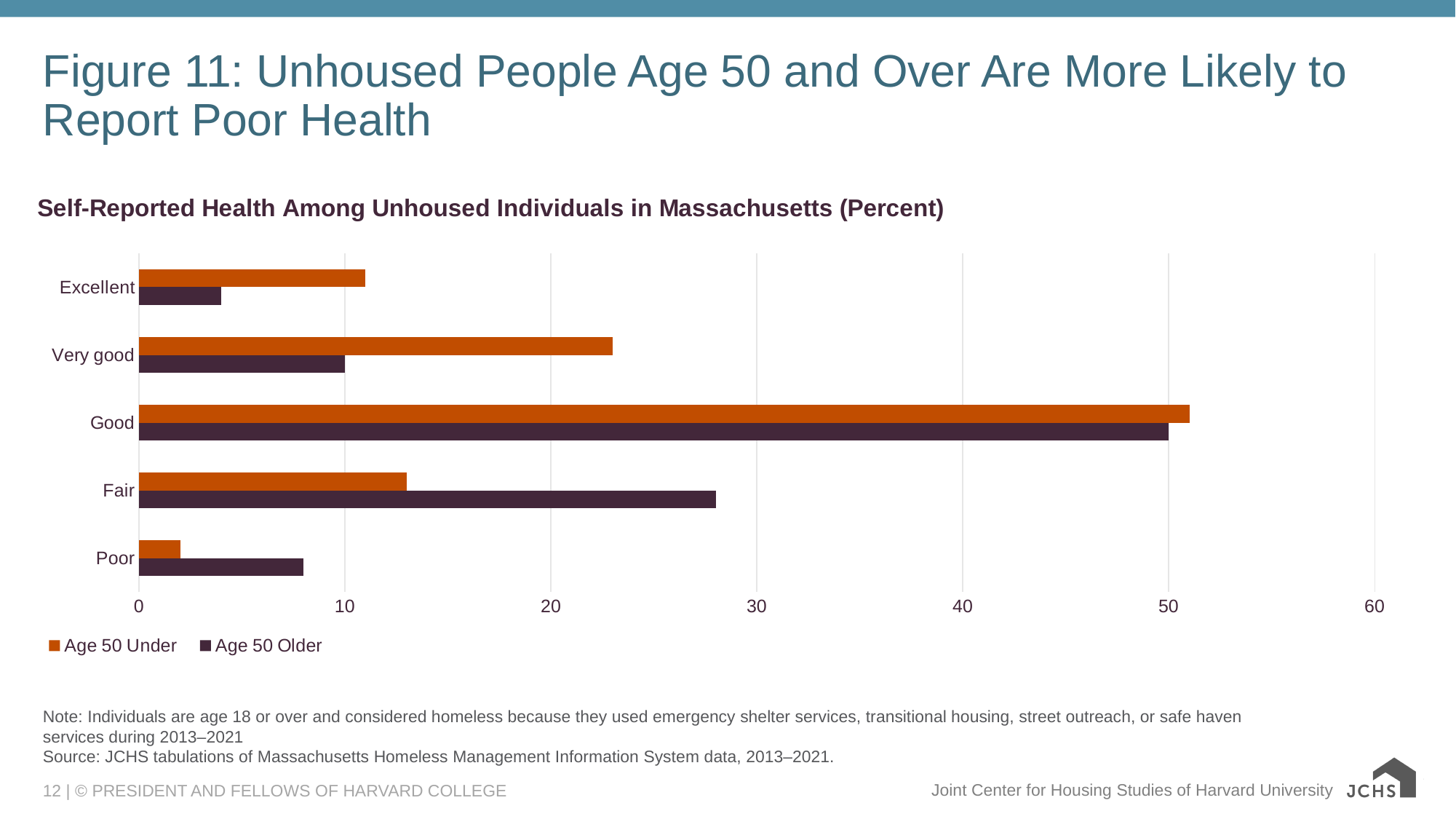
How many series does the legend list? 2 Which health category has the highest value for Age 50 Under? Good For the Fair category, which series has the larger value, Age 50 Under or Age 50 Older? Age 50 Older Which health category has the lowest value for Age 50 Older? Excellent How many health categories are shown on the chart? 5 What kind of chart is shown on the slide? bar chart Is the value for Poor among Age 50 Older greater or less than 10? less What is the title of the chart? Self-Reported Health Among Unhoused Individuals in Massachusetts (Percent) For the Very good category, which series has the larger value, Age 50 Under or Age 50 Older? Age 50 Under Which health category has the lowest value for Age 50 Under? Poor Is the value for Fair among Age 50 Older greater or less than 20? greater Which health category has the highest value for Age 50 Older? Good